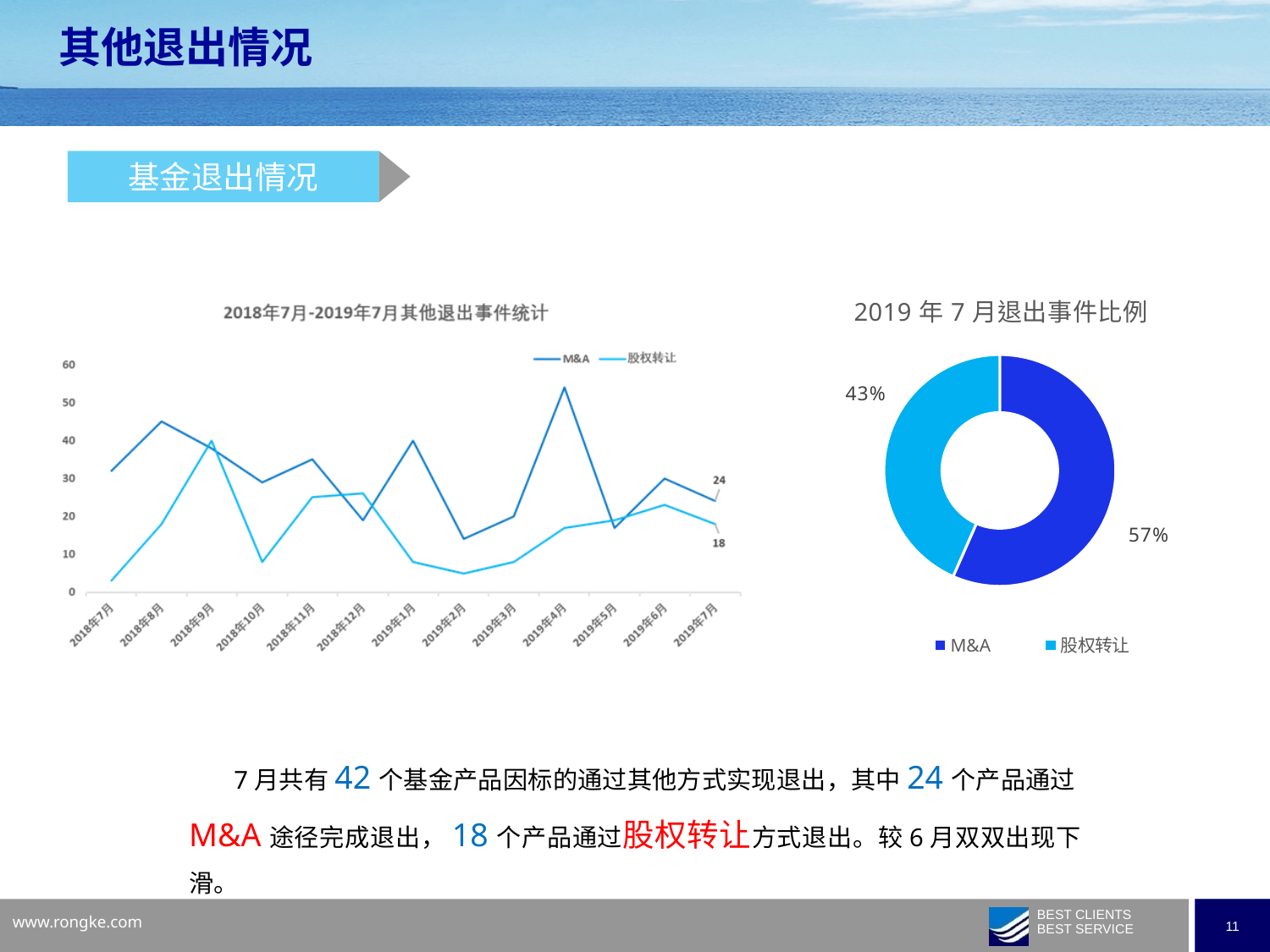
In the chart titled "2019 年 7 月退出事件比例", which category has the larger share, M&A or 股权转让? M&A In the chart titled "2018年7月-2019年7月其他退出事件统计", in which month does the 股权转让 series reach its highest value? 2018年9月 In the chart titled "2018年7月-2019年7月其他退出事件统计", how many series does the legend list? 2 In the chart titled "2018年7月-2019年7月其他退出事件统计", is the M&A value for 2019年4月 greater or less than 50? greater In the chart titled "2018年7月-2019年7月其他退出事件统计", what is the 股权转让 value for 2019年7月? 18 In the chart titled "2018年7月-2019年7月其他退出事件统计", is the 股权转让 value for 2018年7月 greater or less than 10? less What type of chart is the chart titled "2018年7月-2019年7月其他退出事件统计"? line chart In the chart titled "2018年7月-2019年7月其他退出事件统计", how many months are shown on the x axis? 13 In the chart titled "2018年7月-2019年7月其他退出事件统计", what is the M&A value for 2019年7月? 24 In the chart titled "2018年7月-2019年7月其他退出事件统计", what is the difference between the M&A and 股权转让 values for 2019年7月? 6 In the chart titled "2019 年 7 月退出事件比例", what share does M&A account for? 57% In the chart titled "2018年7月-2019年7月其他退出事件统计", in which month does the M&A series reach its highest value? 2019年4月